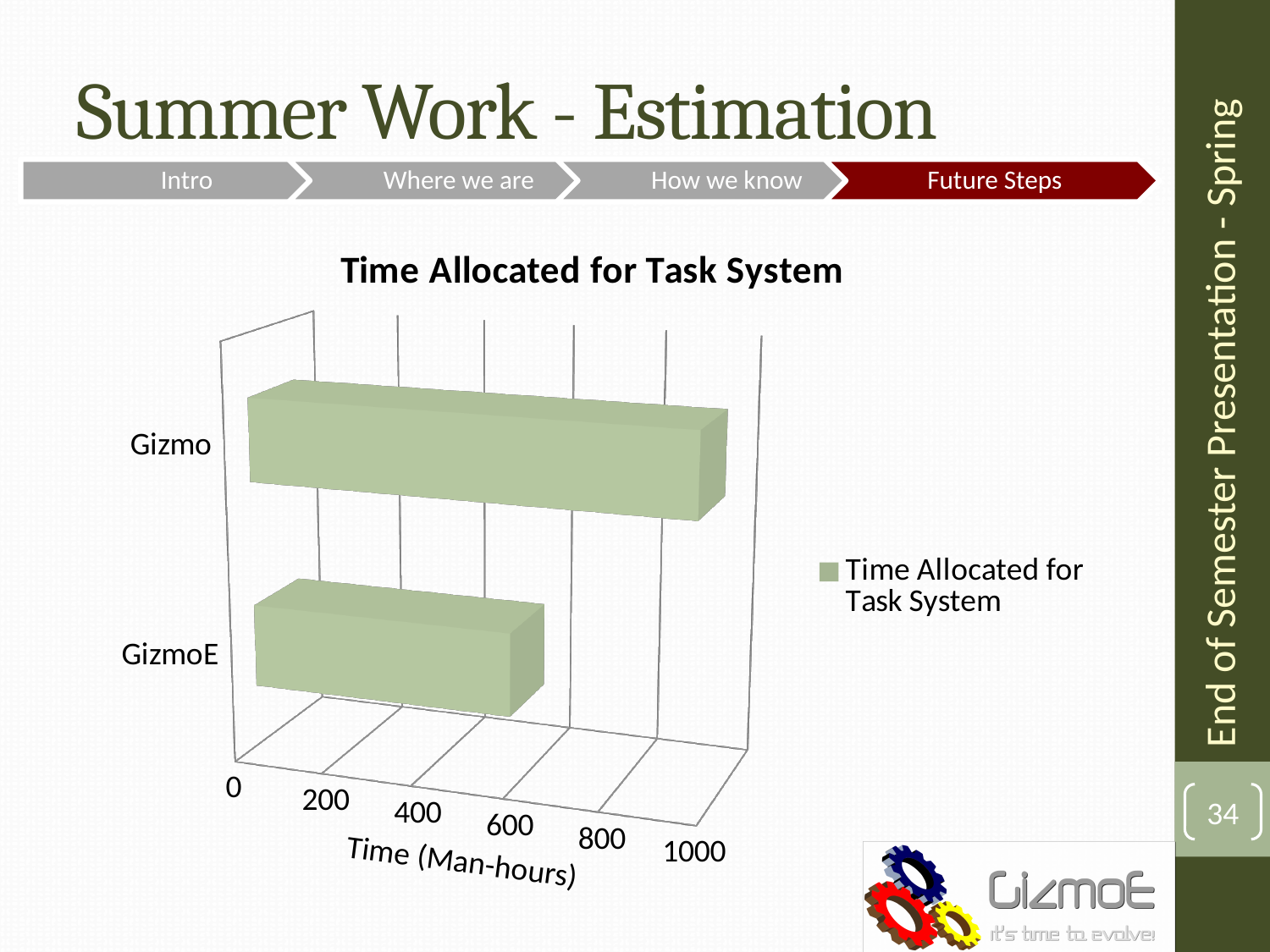
How many series does the legend list? 1 Which has a larger value, Gizmo or GizmoE? Gizmo Which category has the highest time allocated? Gizmo Which category has the lowest time allocated? GizmoE What is the title of the chart? Time Allocated for Task System How many categories are plotted in the chart? 2 What kind of chart is shown on the slide? bar chart What is the label of the horizontal axis? Time (Man-hours) Is the value for Gizmo greater or less than 800? greater Is the value for GizmoE greater or less than 800? less Is the value for GizmoE greater or less than 400? greater